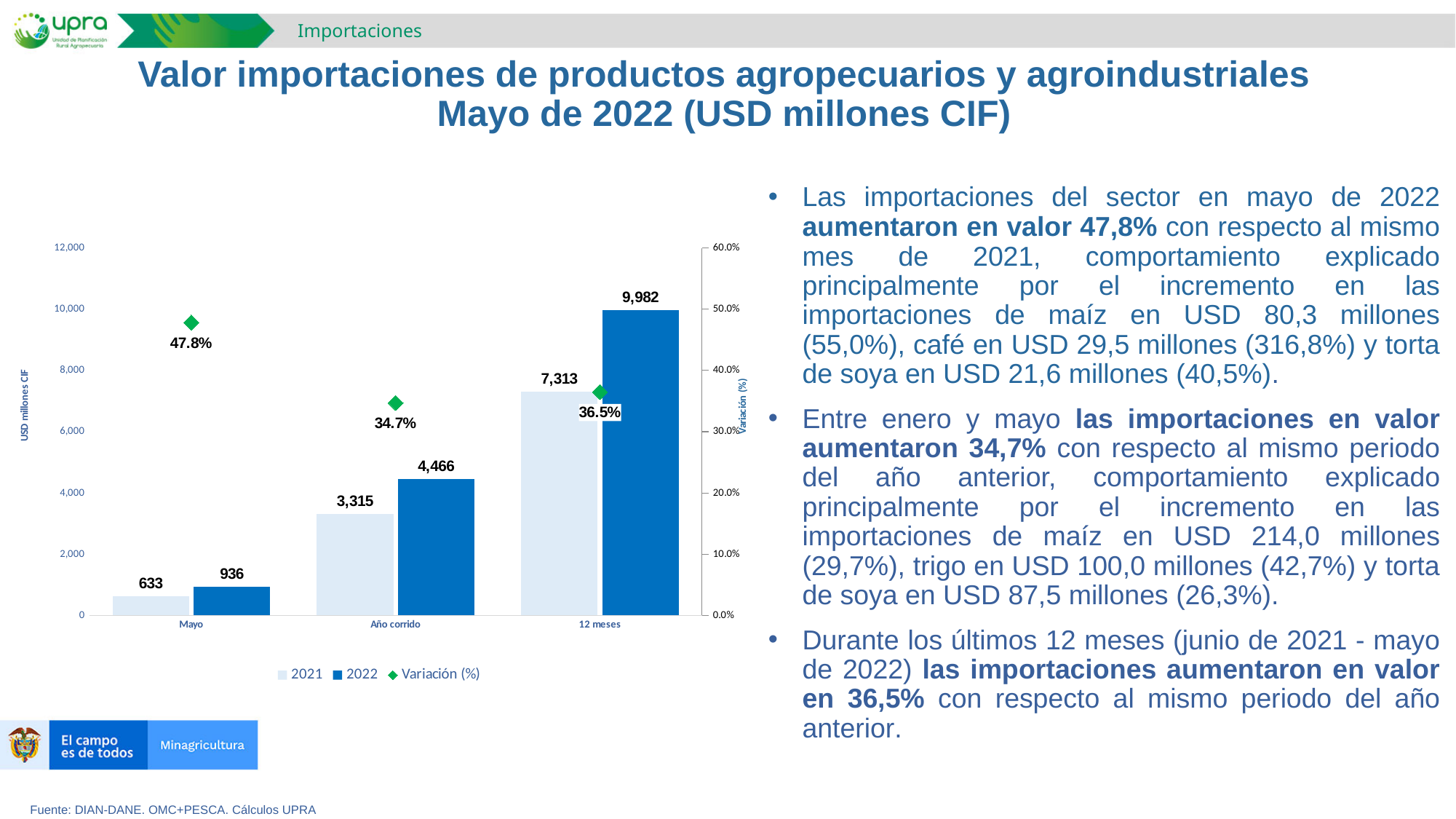
Is the 2022 value for Año corrido greater or less than 4,000? greater What is the Variación (%) value for 12 meses? 36.5% What is the difference between the 2022 and 2021 values for 12 meses? 2,669 How many categories are shown on the x axis? 3 How many series does the legend list? 3 What kind of chart is used for the 2021 and 2022 series? bar chart Which category has the lowest Variación (%)? Año corrido What is the 2021 value for Año corrido? 3,315 Which category has the highest 2022 value? 12 meses What is the label of the left vertical axis? USD millones CIF Which is larger, the 2022 value for Año corrido or the 2021 value for 12 meses? 2021 value for 12 meses What is the 2022 value for Mayo? 936